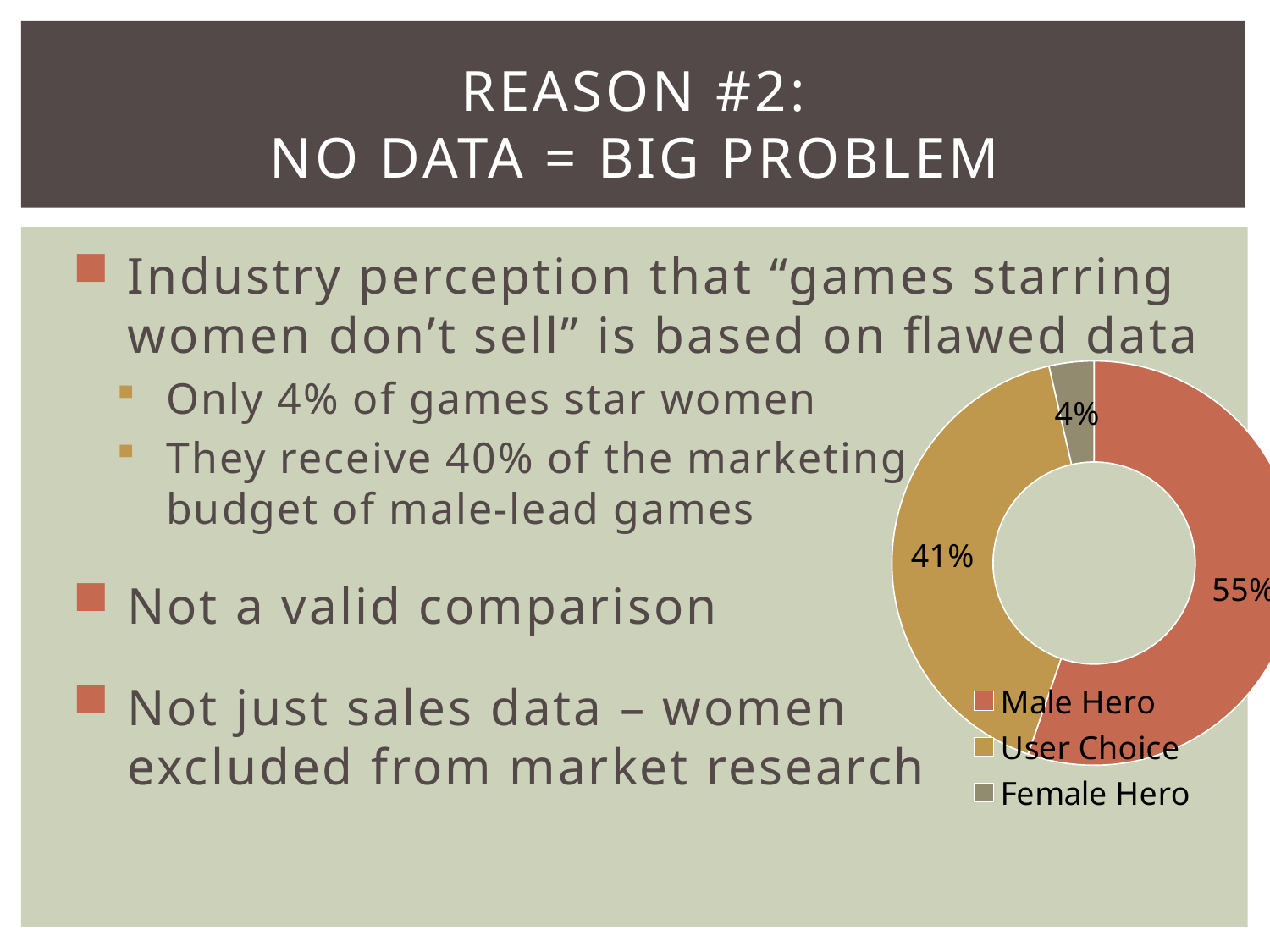
Which category has the largest share in the doughnut chart? Male Hero What share of the doughnut chart is Female Hero? 4% Which is larger, the share for User Choice or the share for Female Hero? User Choice What share of the doughnut chart is Male Hero? 55% Which legend entry is listed last in the chart's legend? Female Hero How many categories does the doughnut chart show? 3 What colour is the Male Hero segment in the chart? Red What is the difference in percentage points between the User Choice and Female Hero shares? 37 What is the difference in percentage points between the Male Hero and User Choice shares? 14 What kind of chart is shown on the slide? Doughnut chart What share of the doughnut chart is User Choice? 41% Which category has the smallest share in the doughnut chart? Female Hero